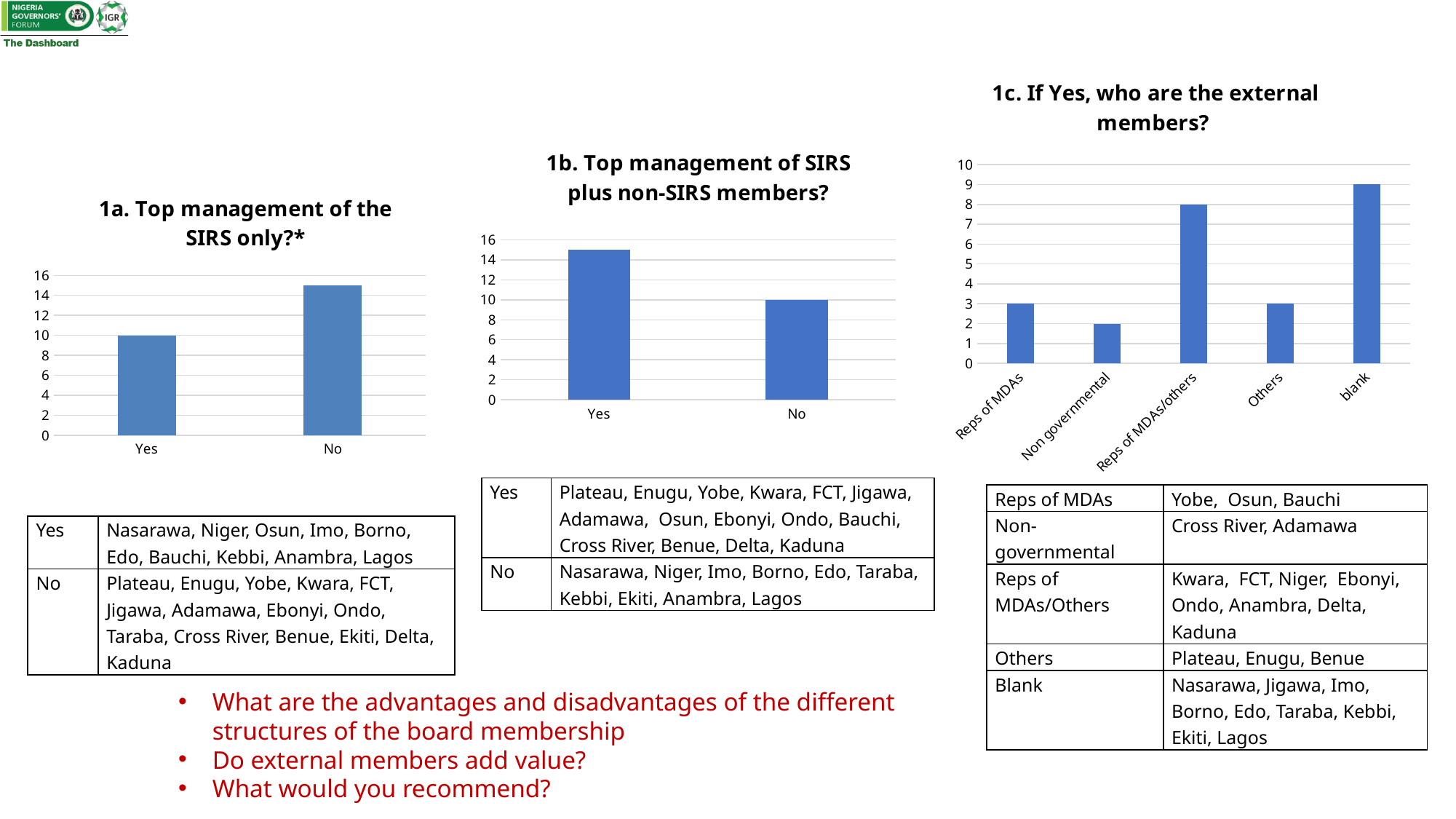
In the chart '1c. If Yes, who are the external members?', which category has the lowest value? Non governmental In the chart '1c. If Yes, who are the external members?', what is the difference between the values for blank and Non governmental? 7 In the chart '1a. Top management of the SIRS only?*', what is the value for Yes? 10 In the chart '1b. Top management of SIRS plus non-SIRS members?', is the value for Yes greater or less than 14? greater What type of chart is '1a. Top management of the SIRS only?*'? Bar chart How many categories are shown in the chart '1c. If Yes, who are the external members?'? 5 In the chart '1b. Top management of SIRS plus non-SIRS members?', which category is highest? Yes In the chart '1c. If Yes, who are the external members?', which category has the highest value? blank In the chart '1a. Top management of the SIRS only?*', which category has the higher value, Yes or No? No In the chart '1c. If Yes, who are the external members?', what is the value for Reps of MDAs/others? 8 In the chart '1a. Top management of the SIRS only?*', is the value for No greater or less than 14? greater In the chart '1b. Top management of SIRS plus non-SIRS members?', what is the value for No? 10